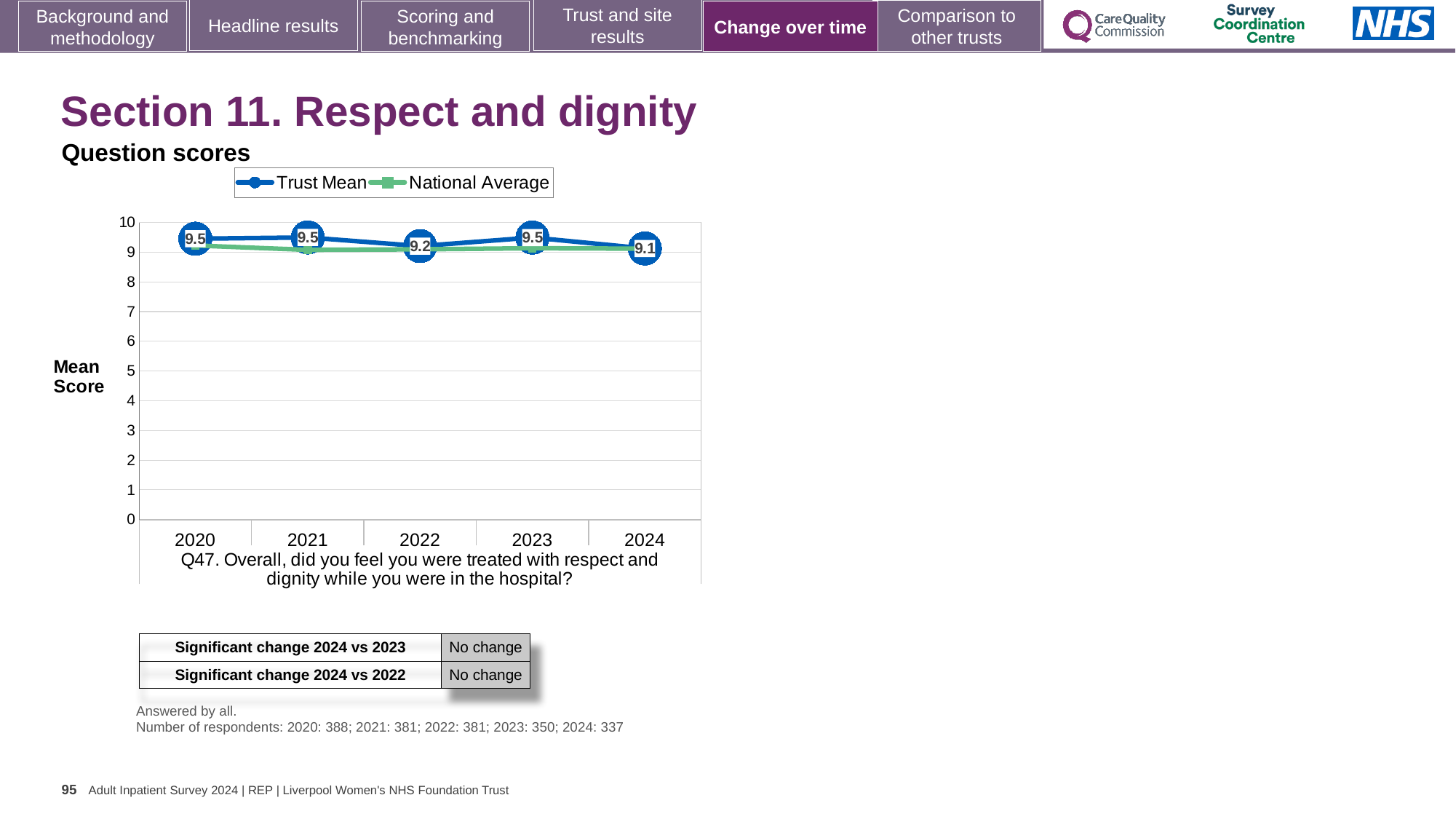
What is the Trust Mean score for 2022? 9.2 What is the Trust Mean score for 2024? 9.1 What is the label on the y axis of the chart? Mean Score What is the difference between the Trust Mean scores for 2023 and 2024? 0.4 Does the Trust Mean score rise or fall from 2023 to 2024? Fall How many years are shown on the x axis of the chart? 5 In which year is the Trust Mean score lowest? 2024 What is the Trust Mean score for 2020? 9.5 Is the National Average value for 2020 greater or less than 8? greater What kind of chart is shown on the slide? Line chart How many series does the legend list? 2 Which year has the higher Trust Mean score, 2021 or 2022? 2021